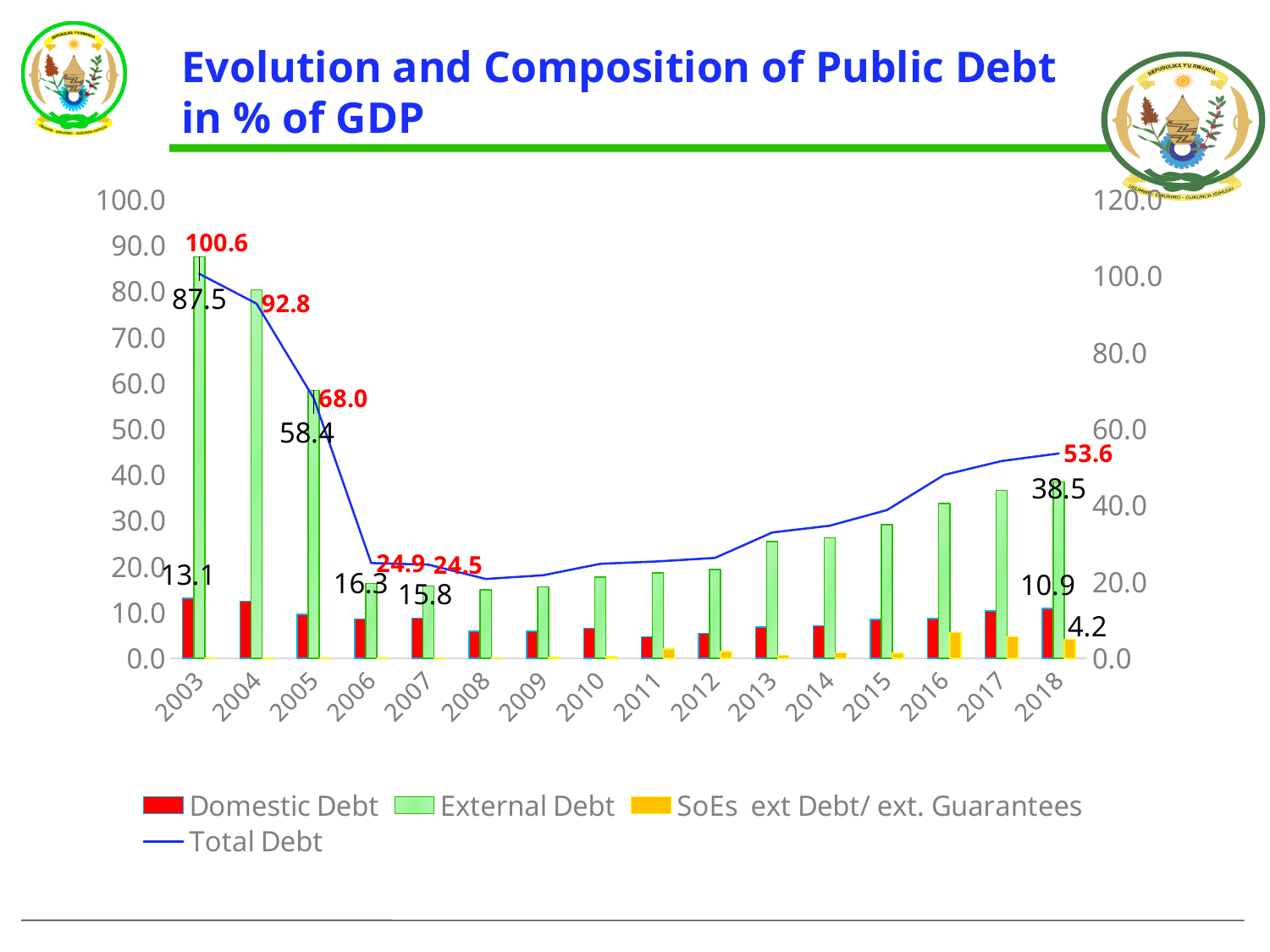
How many years are shown on the x axis? 16 What is the Total Debt value for 2005? 68.0 Is the External Debt value for 2013 greater or less than 20.0 on the left axis? greater Does the Total Debt line rise or fall from 2003 to 2007? Falls What is the Domestic Debt value for 2003? 13.1 What is the difference between the Total Debt in 2003 and in 2018? 47.0 What is the Total Debt value for 2003? 100.6 How many series does the legend list? 4 What is the value for SoEs ext Debt/ ext. Guarantees in 2018? 4.2 What kind of chart is this? Combined bar and line chart Which year has the highest Total Debt? 2003 What is the External Debt value for 2018? 38.5